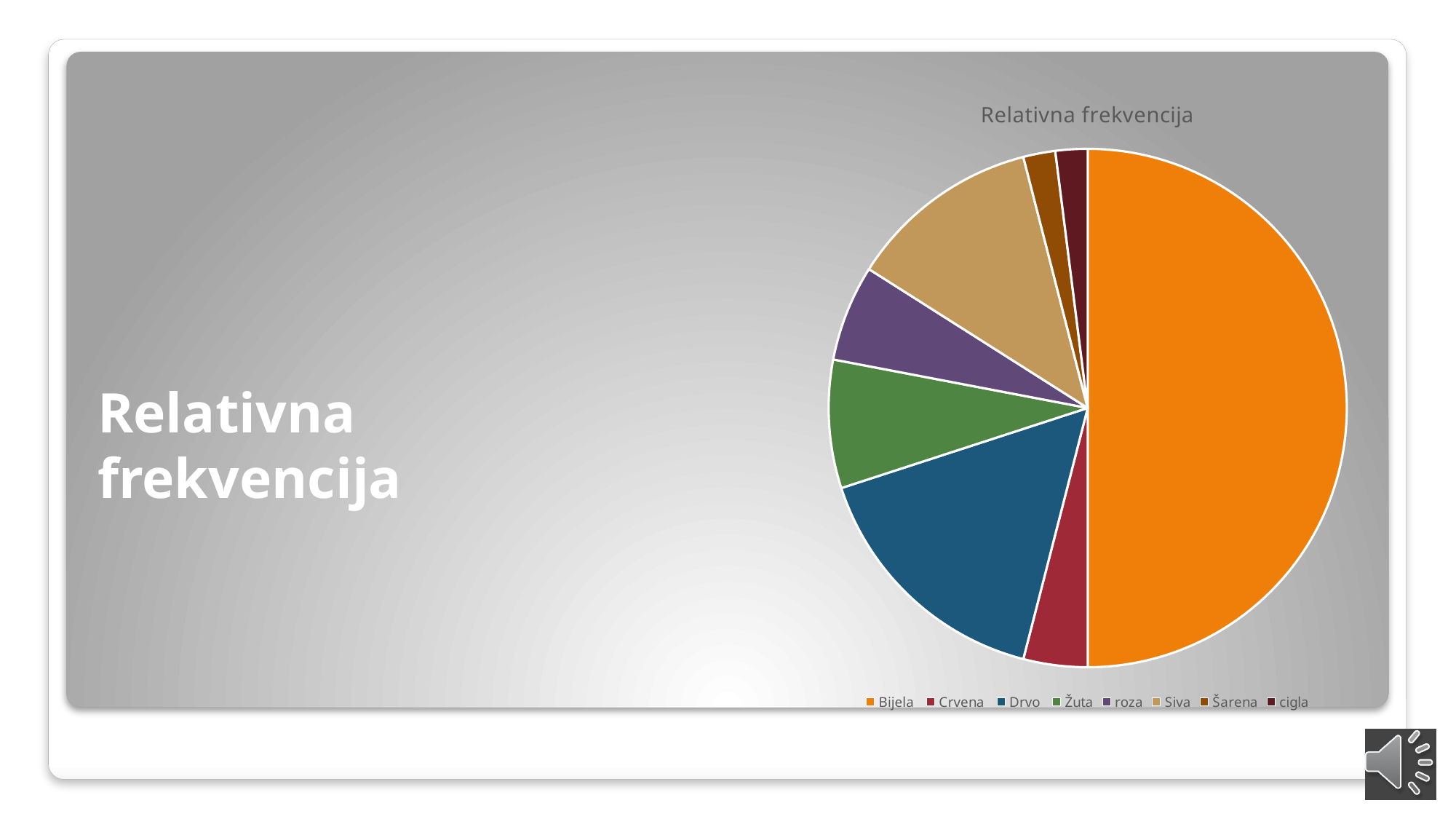
Which slice is larger, Drvo or Žuta? Drvo Which category is shown in orange in the legend? Bijela Which slice is larger, Siva or roza? Siva What is the title of the chart? Relativna frekvencija Which slice is larger, Drvo or Crvena? Drvo Which category has the largest slice of the pie? Bijela How many categories does the pie chart have? 8 What kind of chart is shown on the slide? pie chart